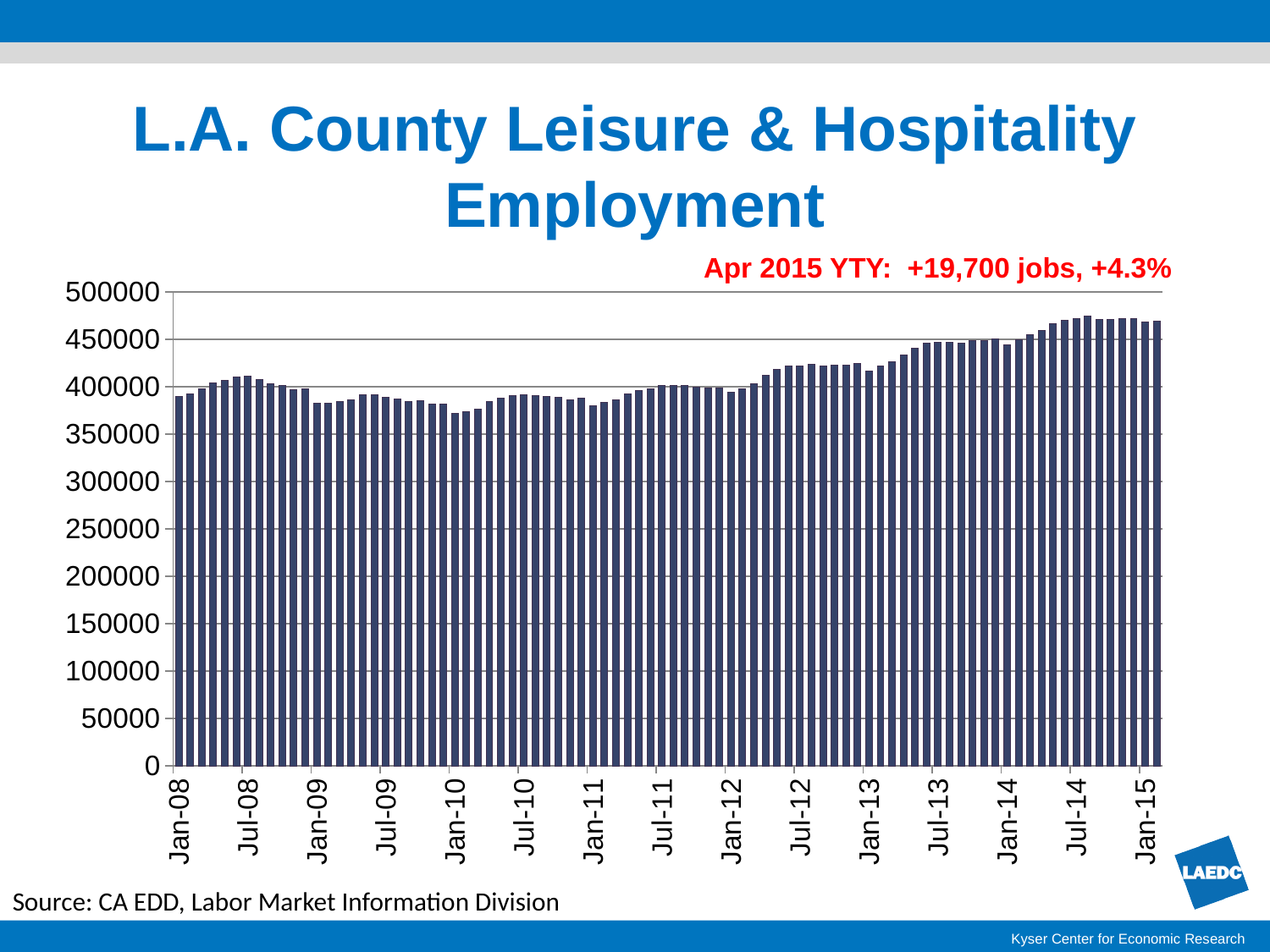
What is the title of the chart? L.A. County Leisure & Hospitality Employment What kind of chart is shown on the slide? bar chart Is the value for Jul-12 greater or less than 400000? greater Is the value for Jan-15 greater or less than 450000? greater Which is larger, the value for Jan-10 or the value for Jan-14? Jan-14 Which is larger, the value for Jul-14 or the value for Jul-08? Jul-14 According to the annotation on the chart, what was the April 2015 year-to-year change in jobs? +19,700 jobs, +4.3% Overall, do the employment values rise or fall from Jan-08 to Jan-15? rise Is the value for Jul-14 greater or less than 450000? greater Which is larger, the value for Jan-15 or the value for Jan-08? Jan-15